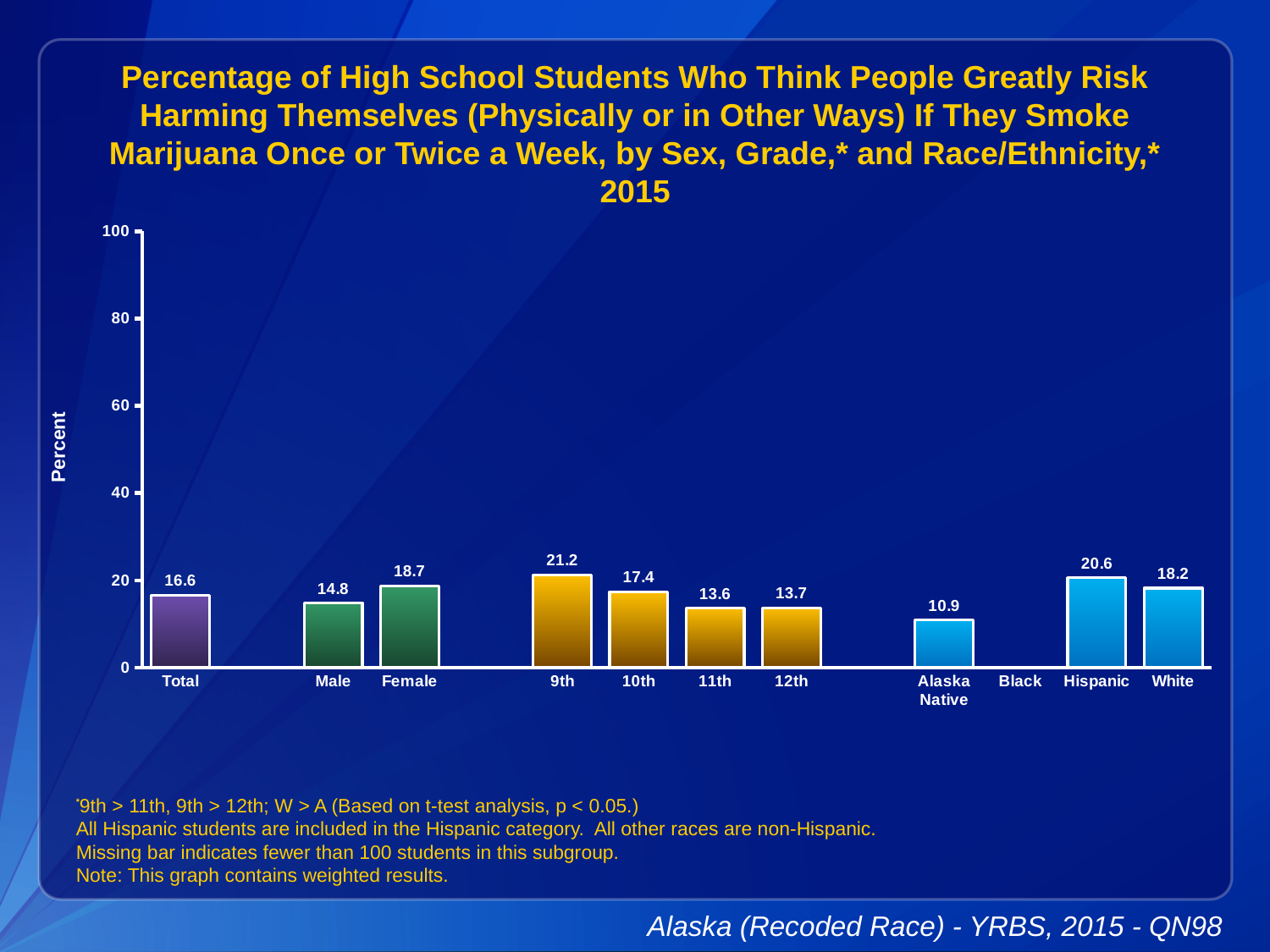
Which category on the x axis has no bar plotted? Black What is the value for Total? 16.6 What is the value for Female? 18.7 Which category has the highest value? 9th Which is larger, the value for Hispanic or the value for White? Hispanic Which category with a plotted bar has the lowest value? Alaska Native What kind of chart is shown? bar chart Do the values fall or rise from 9th to 11th grade? fall How many categories are labelled on the x axis? 12 What is the difference between the values for Female and Male? 3.9 Is the value for 9th greater or less than 20? greater What is the value for Alaska Native? 10.9